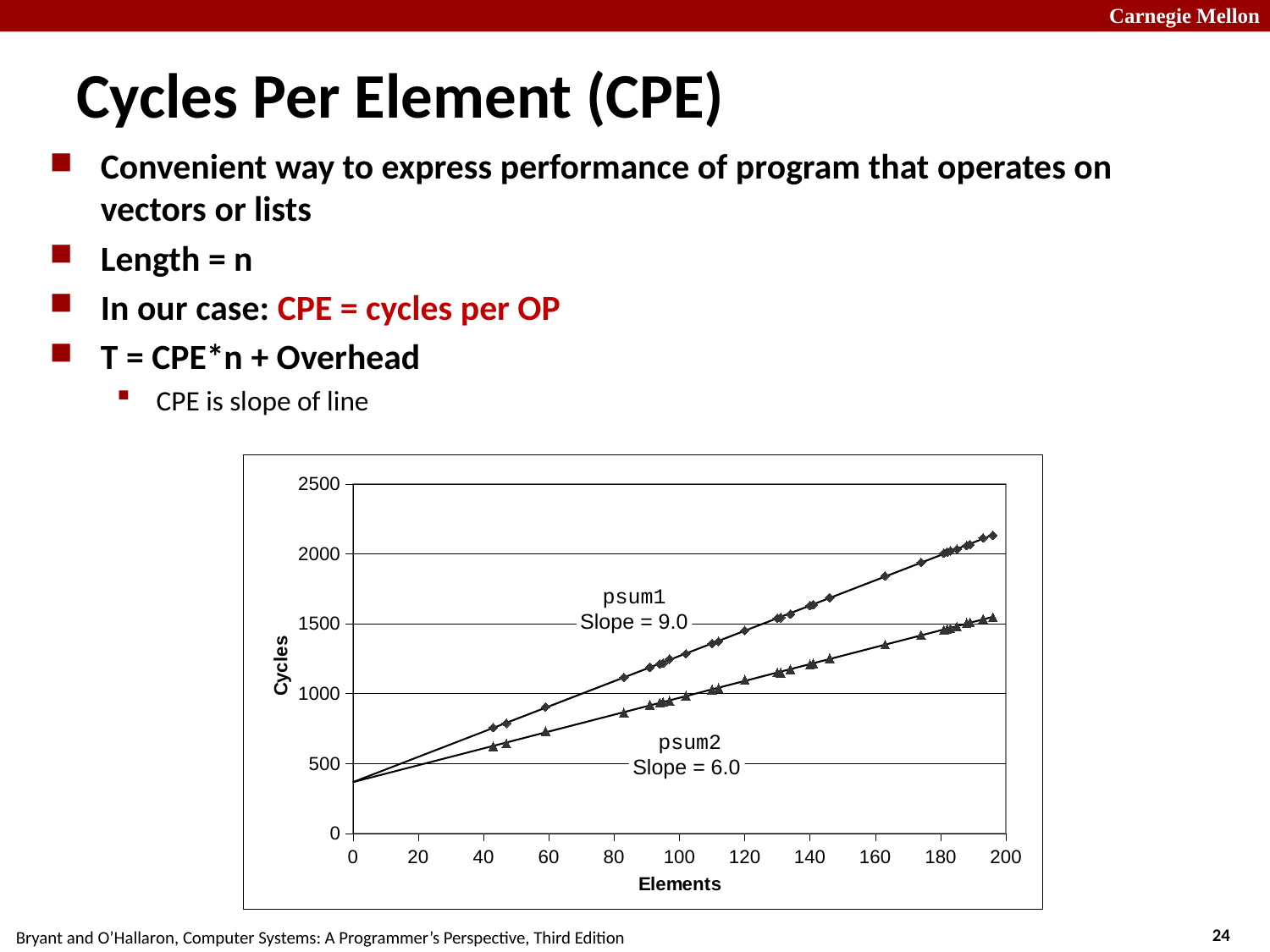
What slope is shown for the psum1 series? 9.0 What slope is shown for the psum2 series? 6.0 Is the value for psum1 at about 160 elements greater or less than 2000 cycles? less Do the cycle counts rise or fall as the number of elements increases? rise How many data series are plotted on the chart? 2 Is the value for psum2 at about 195 elements greater or less than 2000 cycles? less Which series has the steeper slope, psum1 or psum2? psum1 Is the value for psum1 at about 100 elements greater or less than 1000 cycles? greater What is the label of the vertical axis? Cycles What is the label of the horizontal axis? Elements What kind of chart is shown on the slide? scatter (line) chart